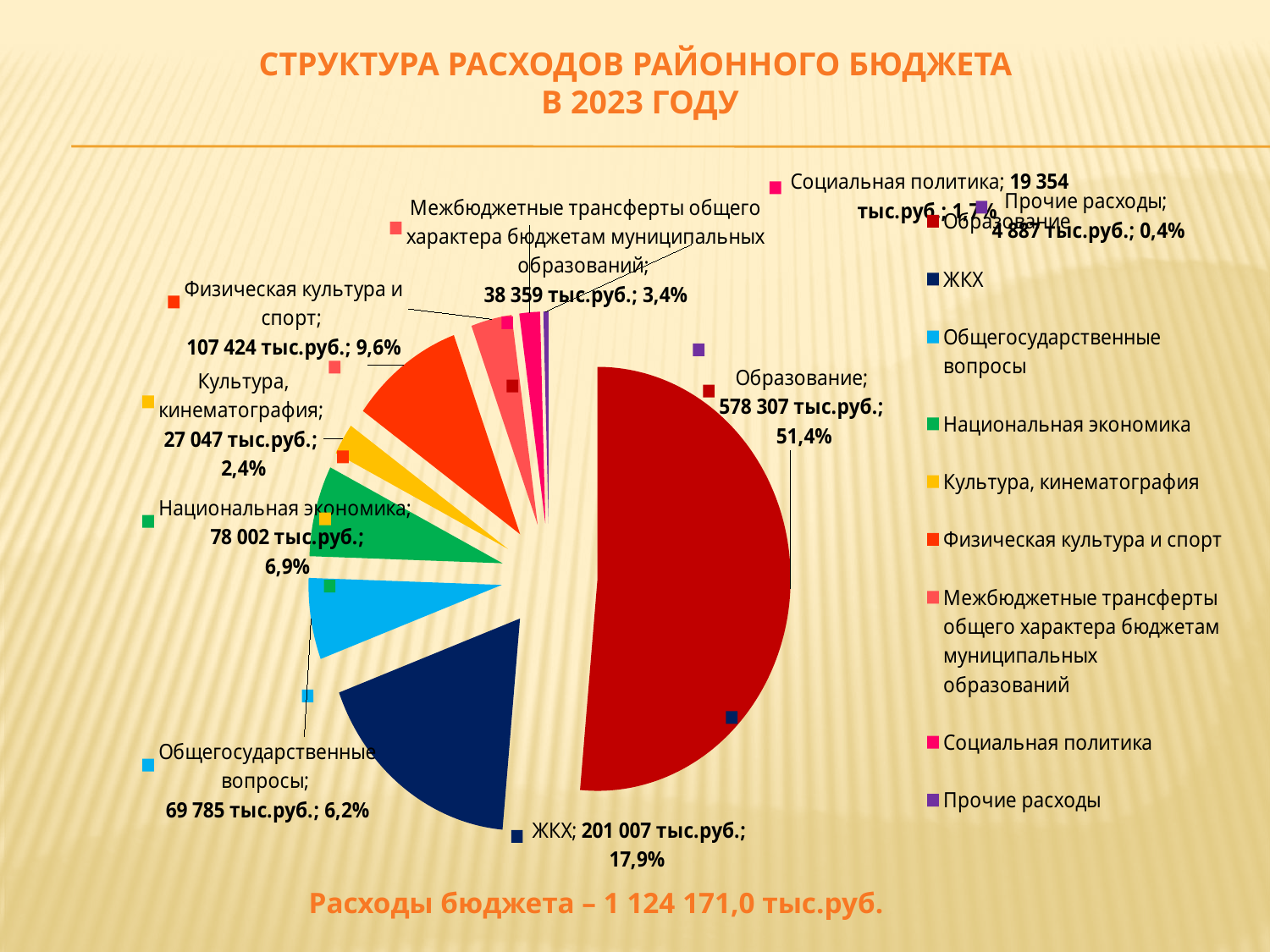
What total budget expenditure is stated below the chart? 1 124 171,0 тыс.руб. How many categories does the legend of the pie chart list? 9 What is the value for ЖКХ in the pie chart? 201 007 тыс.руб. What kind of chart is shown on the slide? pie chart What is the difference in percentage points between the shares of Образование and ЖКХ? 33,5 Which is larger: Национальная экономика or Общегосударственные вопросы? Национальная экономика What share of the district budget expenditure goes to Образование? 51,4% What is the value for Физическая культура и спорт? 107 424 тыс.руб. Which category has the largest slice of the pie chart? Образование What is the value for Культура, кинематография? 27 047 тыс.руб. Which category has the smallest slice of the pie chart? Прочие расходы What share of the pie does Социальная политика represent? 1,7%